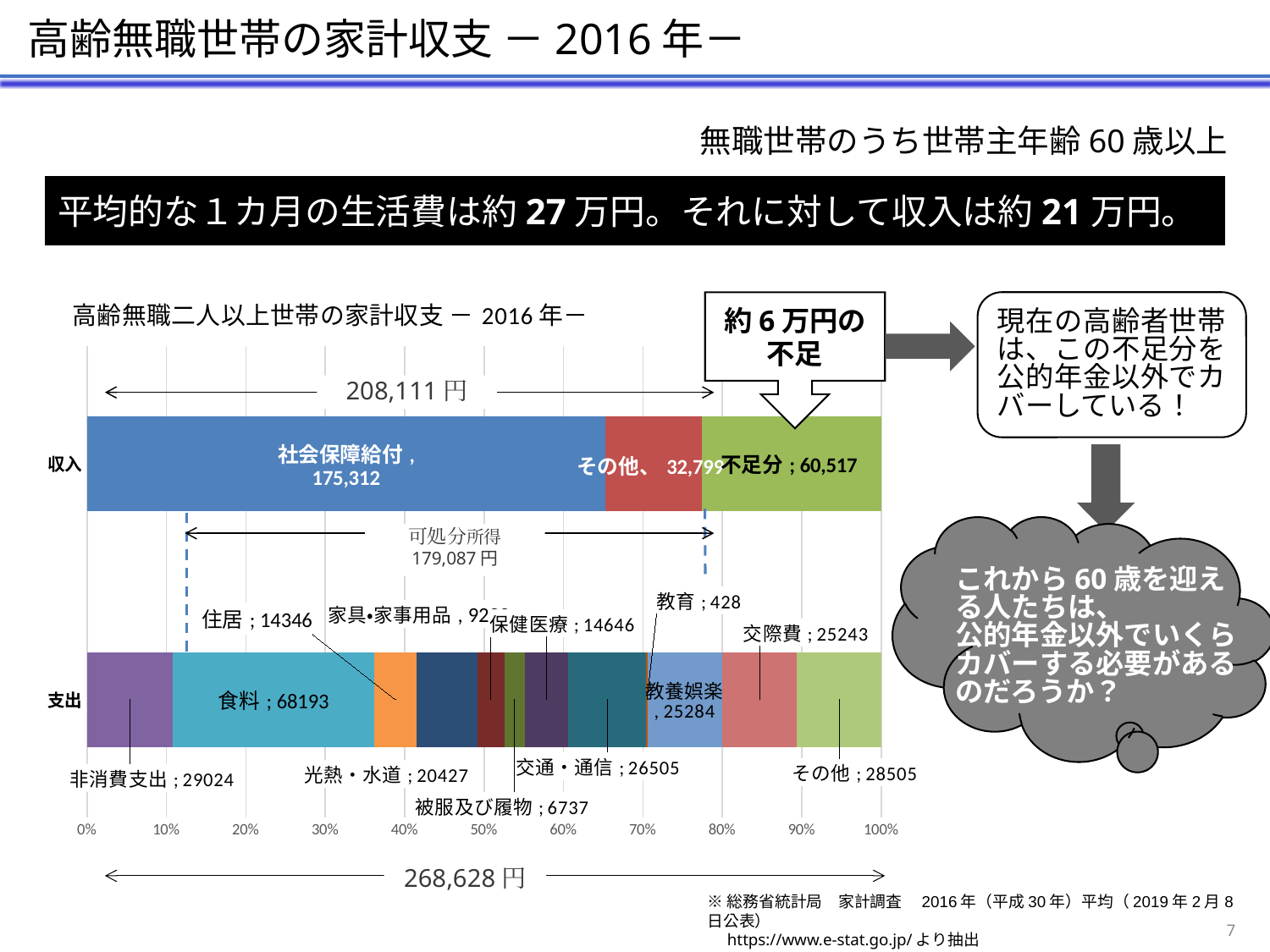
What is the value of 食料 in the 支出 bar? 68193 Which is larger in the 支出 bar, 交通・通信 or 光熱・水道? 交通・通信 What is the value of 教育 in the 支出 bar? 428 What is the value of 不足分 in the 収入 bar? 60,517 What is the 可処分所得 value shown on the chart? 179,087 円 What is the difference between 教養娯楽 and 交際費 in the 支出 bar? 41 What is the value of 社会保障給付 in the 収入 bar? 175,312 Which segment of the 支出 bar has the largest value? 食料 What is the total of the 支出 bar as labelled on the chart? 268,628 円 Which segment of the 支出 bar has the smallest value? 教育 What type of chart is shown on the slide? Bar chart How many bars (categories) are shown on the chart's vertical axis? 2